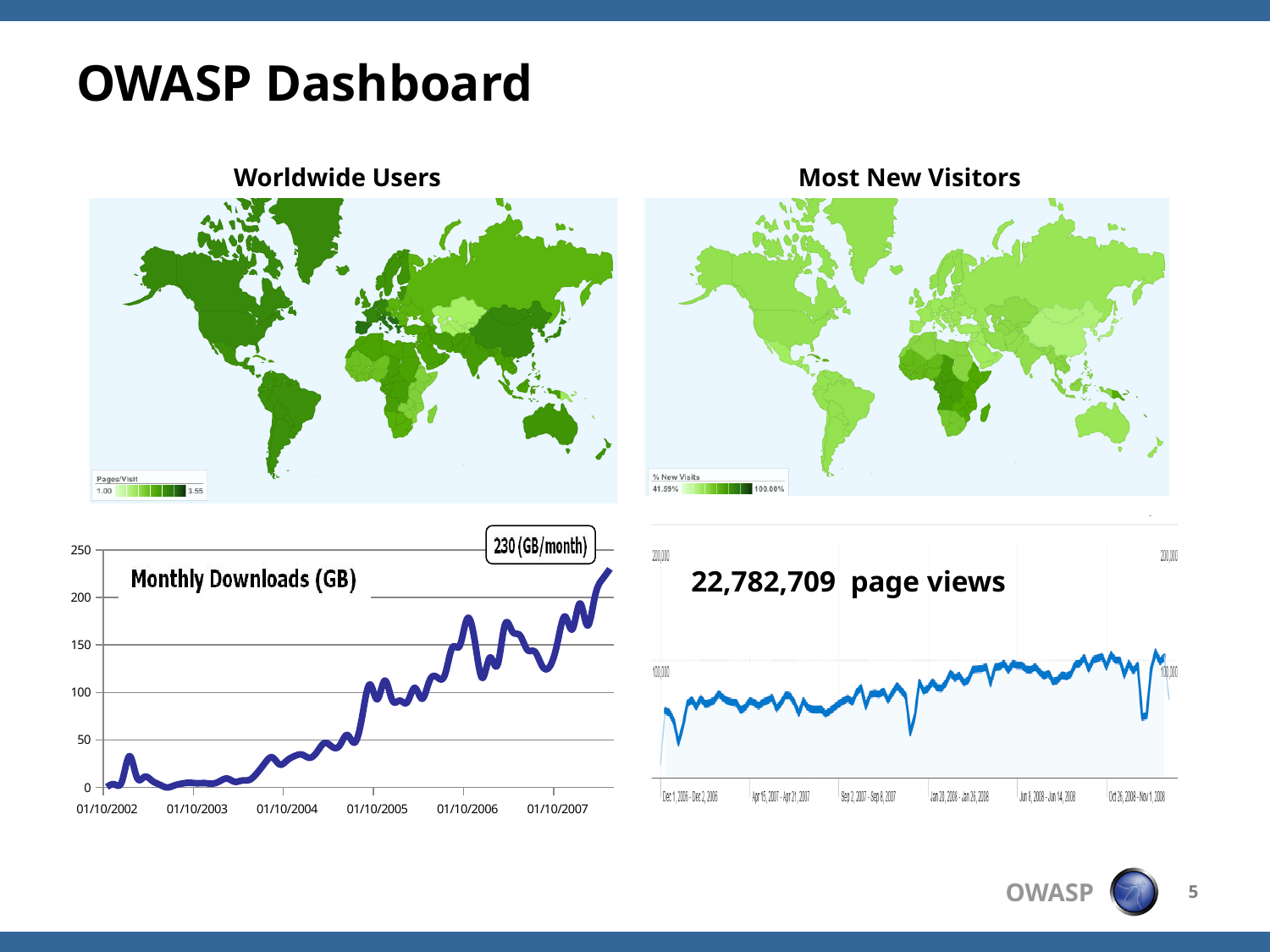
On the Monthly Downloads (GB) chart, is the value at 01/10/2006 greater or less than 100? greater On the Monthly Downloads (GB) chart, do the values generally rise or fall from 01/10/2002 to 01/10/2007? rise On the Monthly Downloads (GB) chart, what value does the annotation at the end of the line give? 230 (GB/month) What is the title of the map at the top right of the slide? Most New Visitors On the Monthly Downloads (GB) chart, is the value at the end of the line (late 2007) greater or less than 200? greater What kind of chart is the Monthly Downloads (GB) chart at the bottom left of the slide? line chart On the page views chart at the bottom right, is the line ever greater or less than 200,000? less On the page views chart at the bottom right, what total number of page views is printed? 22,782,709 page views On the page views chart at the bottom right, do the values generally rise or fall from Dec 2006 to Nov 2008? rise On the Monthly Downloads (GB) chart, what is the highest value shown on the y axis? 250 How many date labels are shown on the x axis of the Monthly Downloads (GB) chart? 6